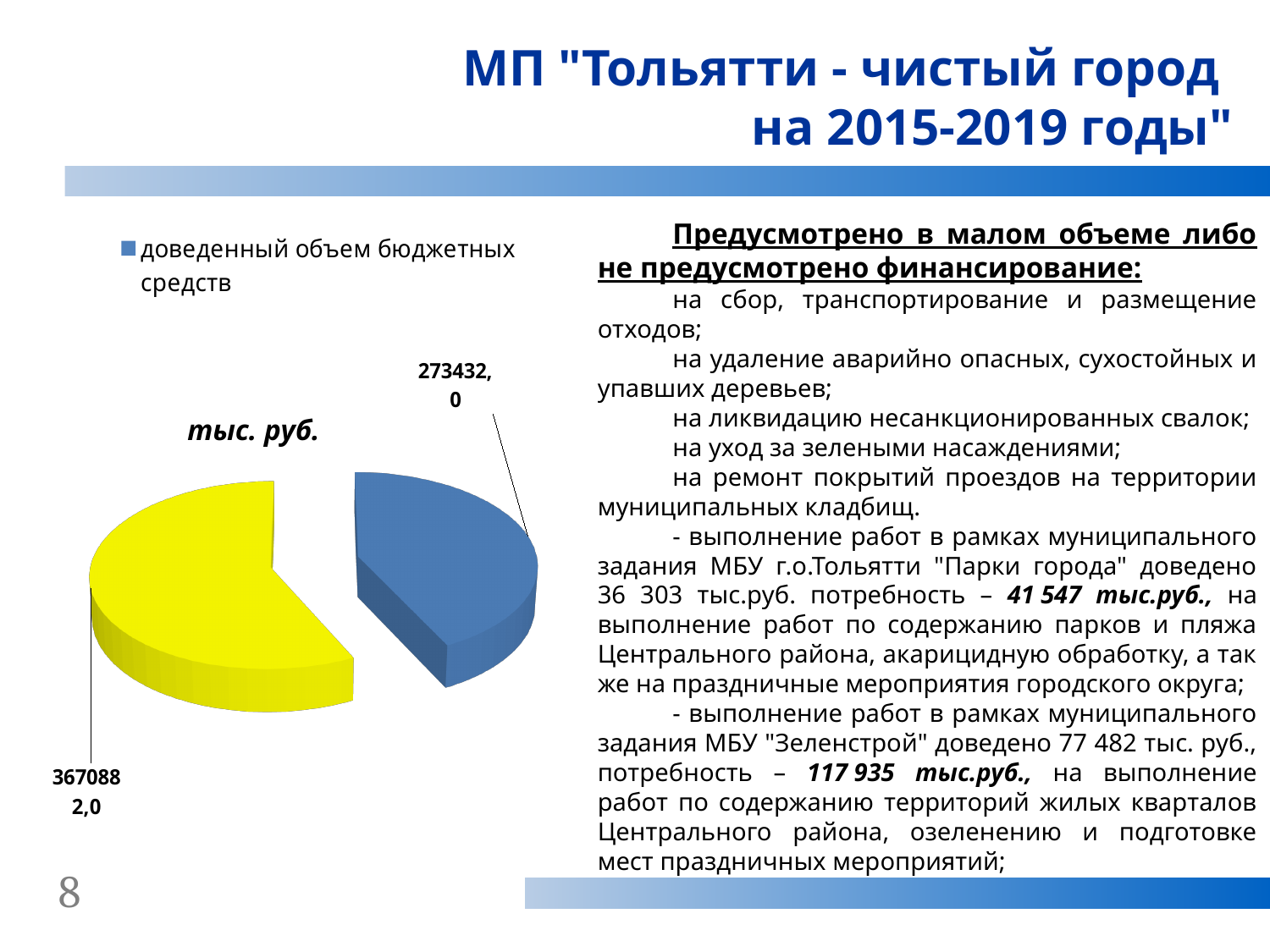
What is the legend entry of the pie chart? доведенный объем бюджетных средств What is the value shown for the yellow slice of the pie chart? 3670882,0 What is the value shown for the blue slice of the pie chart? 273432,0 Which slice of the pie chart is larger, the blue one or the yellow one? the yellow one How many series does the legend of the pie chart list? 1 Which slice of the pie chart has the largest value? the yellow slice (3670882,0) What kind of chart is shown on the slide? pie chart How many slices does the pie chart have? 2 Which slice of the pie chart has the smallest value? the blue slice (273432,0) What unit label is printed next to the pie chart? тыс. руб.